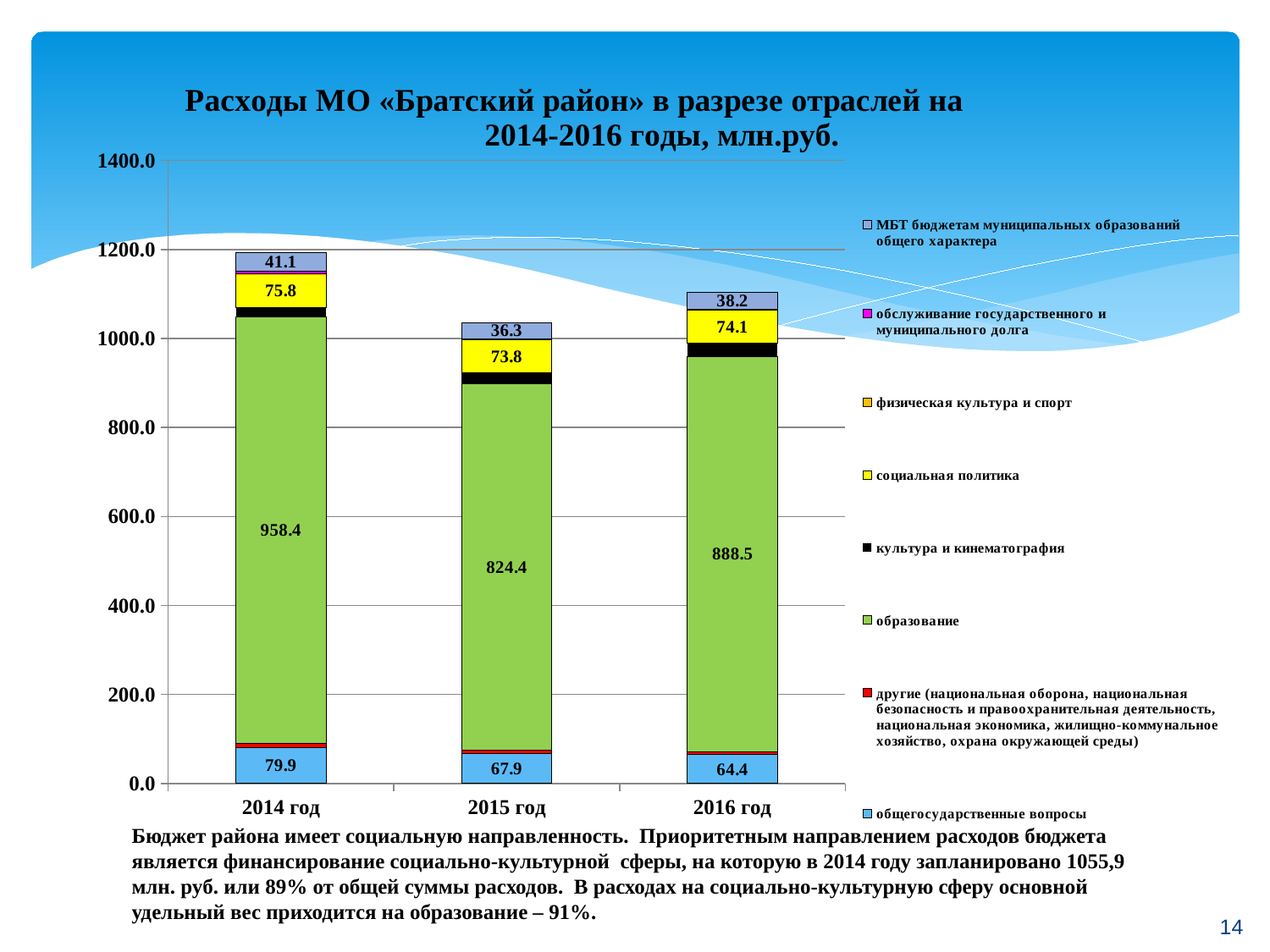
Is the total height of the stacked bar for 2015 год greater or less than 1200.0? less Does the value for общегосударственные вопросы rise or fall from 2014 год to 2016 год? fall In which year is the value for образование the lowest? 2015 год What is the value for образование in 2014 год? 958.4 What is the value for МБТ бюджетам муниципальных образований общего характера in 2016 год? 38.2 How many years are shown on the x axis? 3 What is the value for социальная политика in 2015 год? 73.8 How many series does the legend list? 8 What is the difference between the образование values for 2014 год and 2016 год? 69.9 In which year is the value for общегосударственные вопросы the highest? 2014 год Which is larger: социальная политика in 2014 год or in 2016 год? 2014 год What is the value for общегосударственные вопросы in 2016 год? 64.4